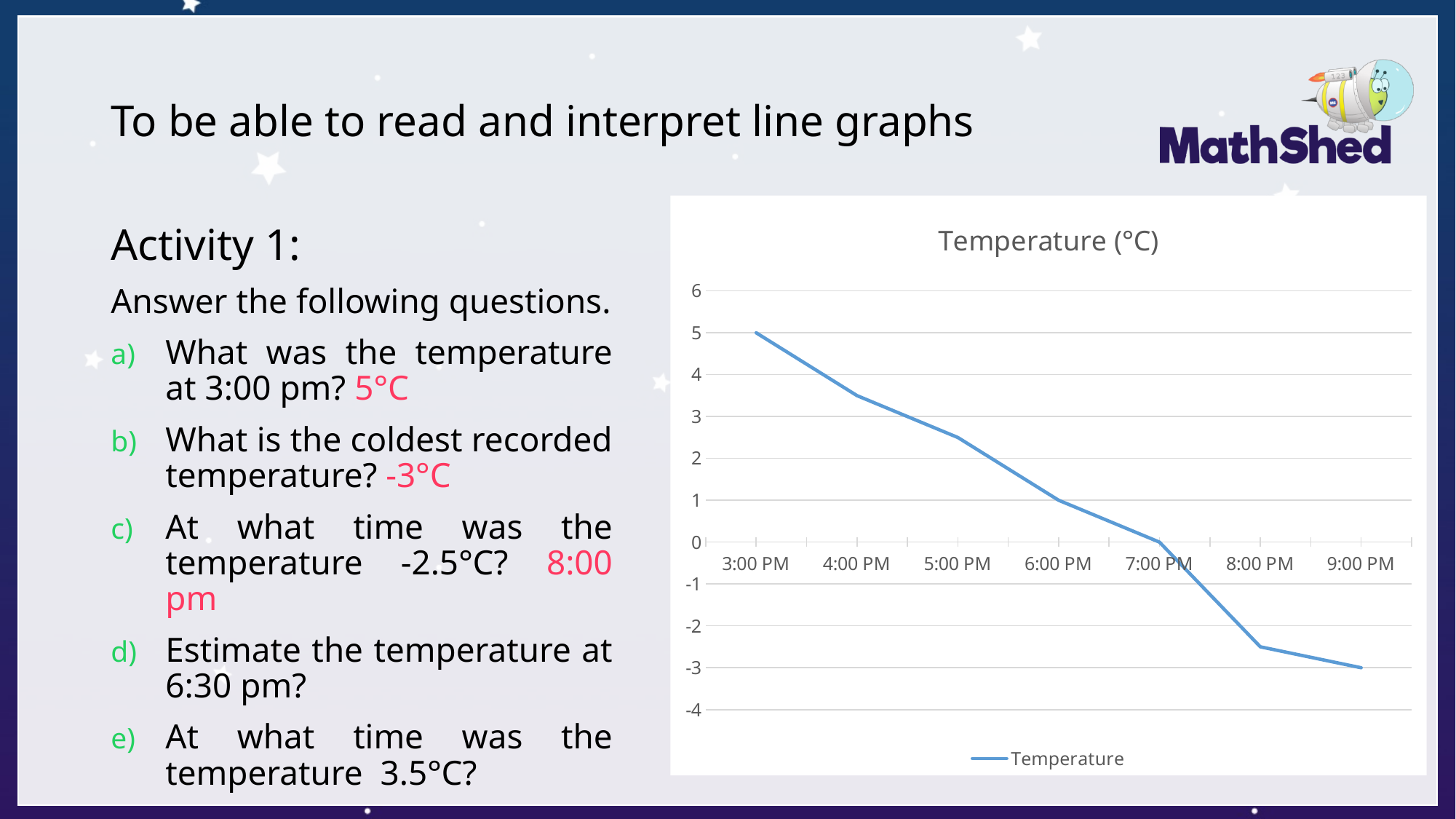
What was the temperature at 9:00 PM? -3 At which time was the temperature lowest? 9:00 PM What was the temperature at 3:00 PM? 5 Is the temperature at 4:00 PM greater or less than 3? greater At which time was the temperature highest? 3:00 PM How many time points are plotted on the chart? 7 Does the temperature rise or fall from 3:00 PM to 9:00 PM? fall How many series does the legend list? 1 What was the temperature at 6:00 PM? 1 What kind of chart is shown on the slide? line chart What was the temperature at 7:00 PM? 0 What is the title of the chart? Temperature (°C)